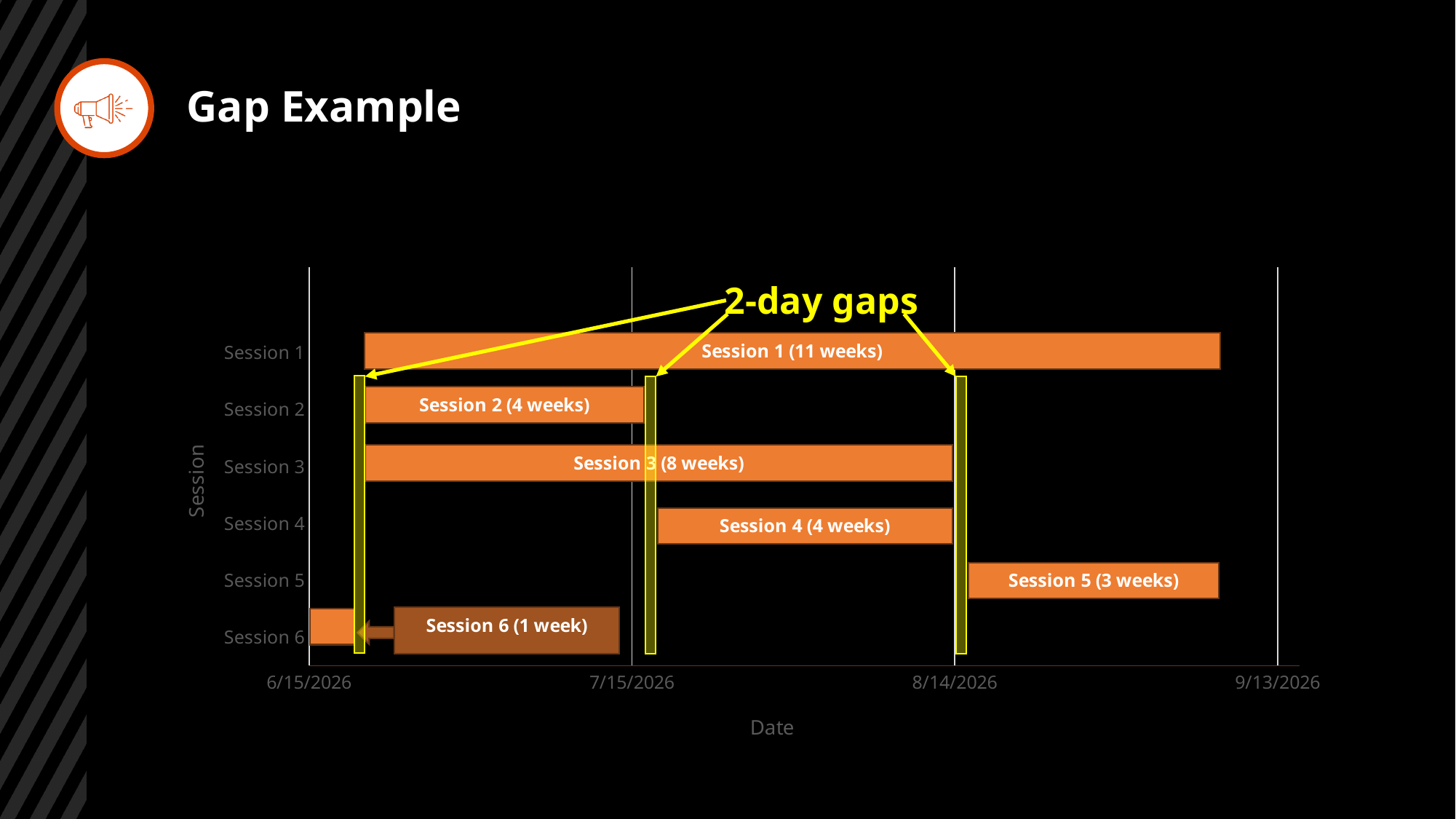
How many weeks long is Session 3 according to its bar label? 8 weeks How long is Session 6 according to its bar label? 1 week How many weeks long is Session 1 according to its bar label? 11 weeks What kind of chart is shown on the slide? Bar chart (Gantt-style) Which session has the longest duration? Session 1 How many sessions are shown on the chart? 6 Which is longer, Session 3 or Session 5? Session 3 How many weeks long is Session 5 according to its bar label? 3 weeks How many weeks longer is Session 1 than Session 2? 7 weeks How many weeks longer is Session 3 than Session 4? 4 weeks What is the label on the horizontal axis of the chart? Date Which session has the shortest duration? Session 6